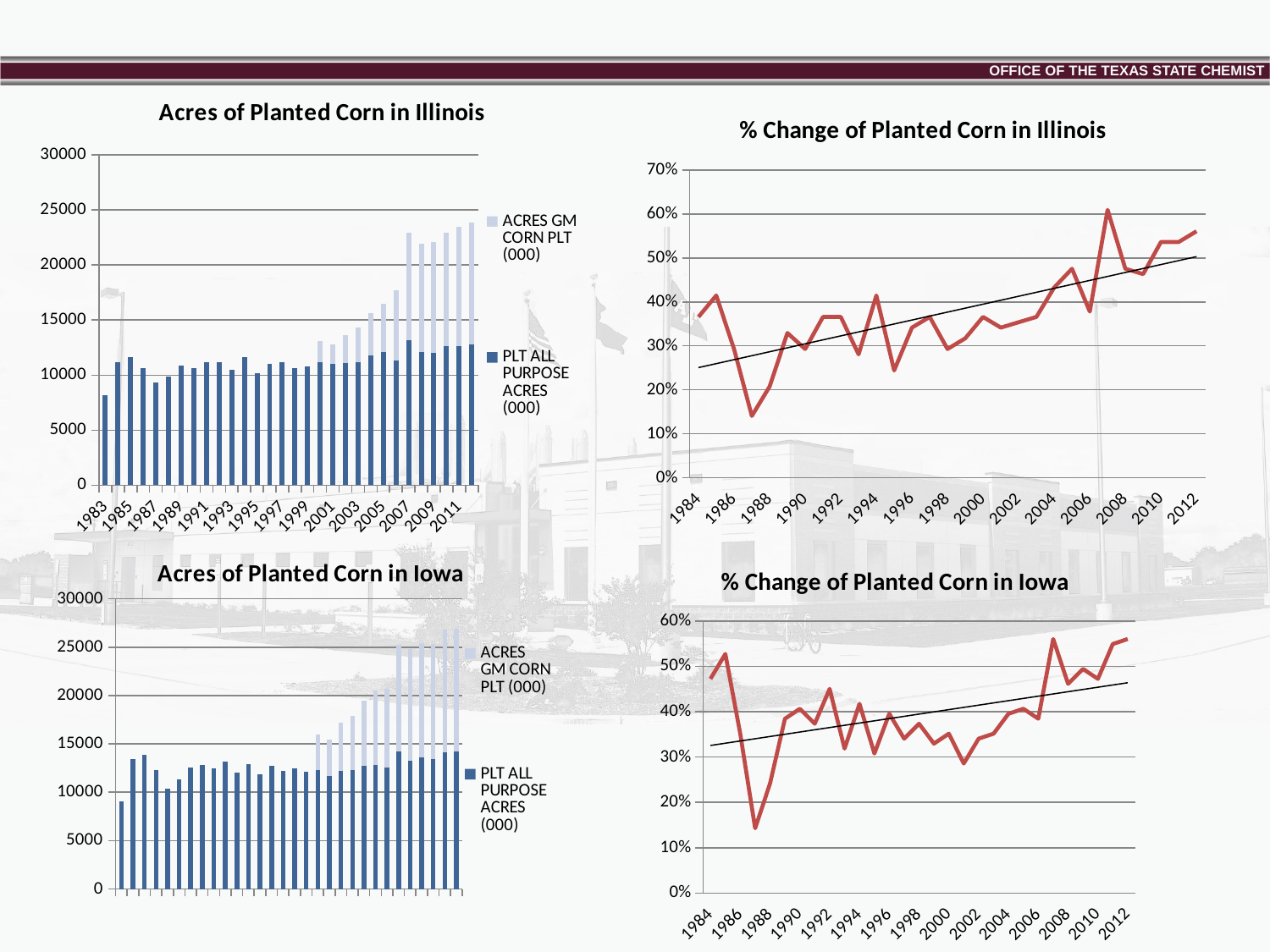
In "% Change of Planted Corn in Illinois", which year has the highest value? 2007 How many charts are shown on the slide? 4 In "% Change of Planted Corn in Iowa", does the straight trend line rise or fall from 1984 to 2012? rise In "Acres of Planted Corn in Iowa", is the PLT ALL PURPOSE ACRES (000) value for 1983 greater or less than 10000? less How many series does the legend of "Acres of Planted Corn in Iowa" list? 2 In "Acres of Planted Corn in Illinois", is the ACRES GM CORN PLT (000) value for 2011 greater or less than 20000? less What kind of chart is "% Change of Planted Corn in Illinois"? line chart What kind of chart is "Acres of Planted Corn in Illinois"? bar chart In "Acres of Planted Corn in Illinois", is the PLT ALL PURPOSE ACRES (000) value for 1983 greater or less than 10000? less In "% Change of Planted Corn in Iowa", which year has the lowest value? 1987 In "% Change of Planted Corn in Illinois", which year has the lowest value? 1987